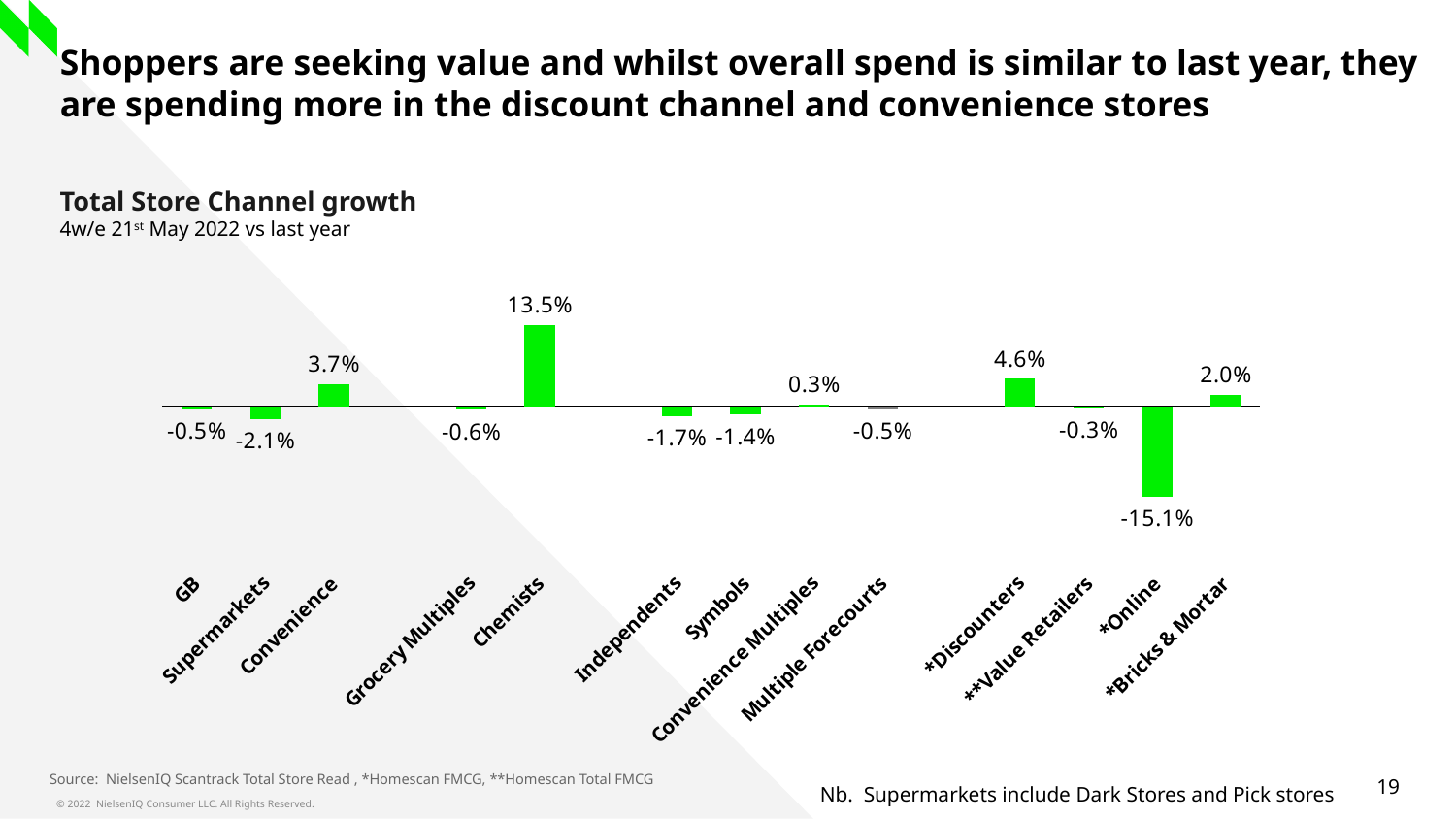
How many channels are plotted in the Total Store Channel growth chart? 13 Which channel has the lowest growth in the chart? *Online What type of chart is used to show Total Store Channel growth? Bar chart What is the difference in percentage points between the Chemists value and the *Online value? 28.6 percentage points Which channel's bar is coloured grey rather than green? Multiple Forecourts Which has the higher growth value, Supermarkets or Independents? Independents By how many percentage points does *Discounters growth exceed Convenience growth? 0.9 percentage points What is the growth value for Supermarkets? -2.1% What is the growth value for *Online in the Total Store Channel growth chart? -15.1% What is the growth value for *Discounters? 4.6% What is the growth value for Chemists in the Total Store Channel growth chart? 13.5% Which channel has the highest growth in the chart? Chemists